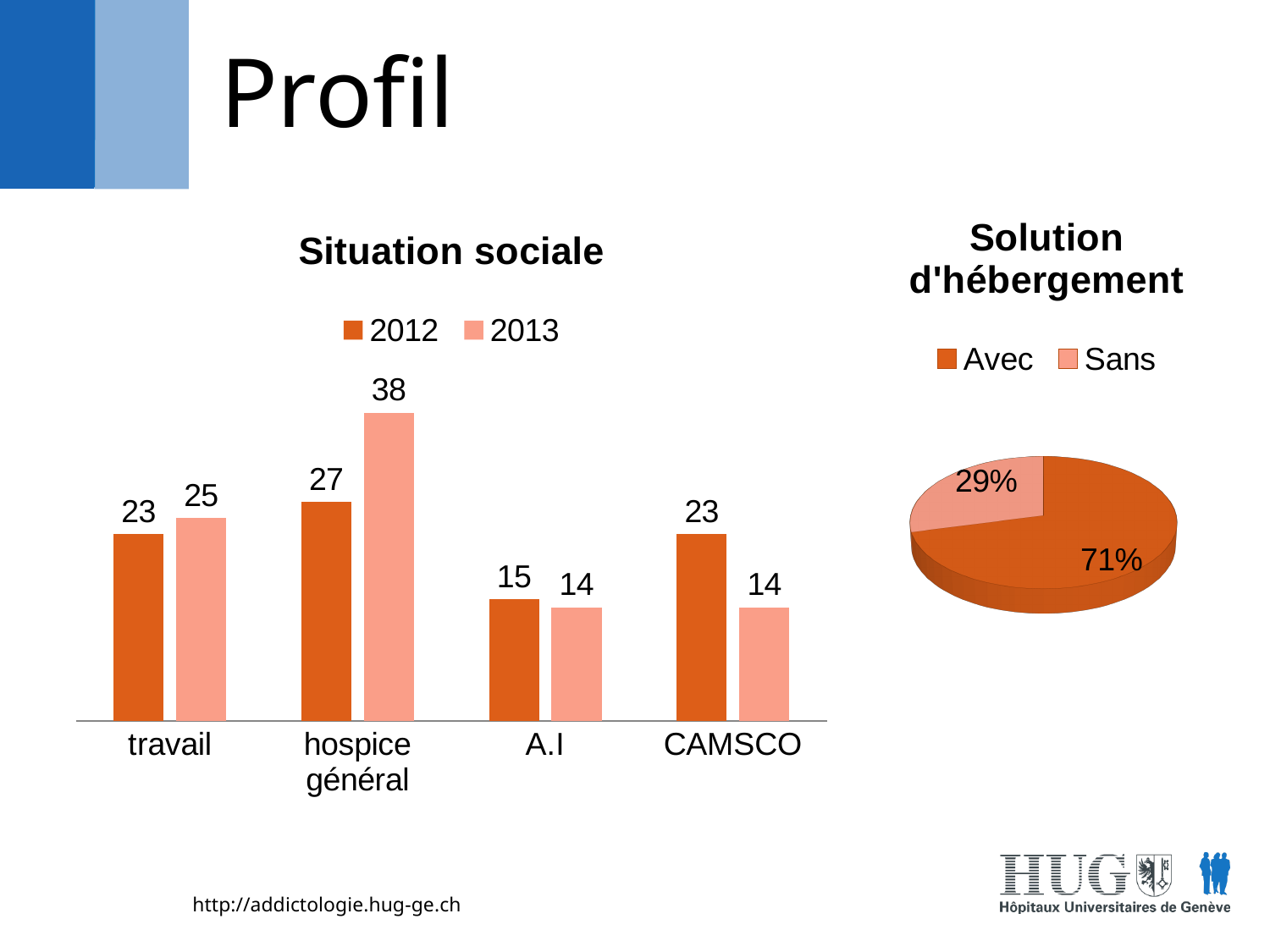
In the 'Situation sociale' chart, which category has the lowest value for 2012? A.I What kind of chart is the 'Solution d'hébergement' chart? pie chart In the 'Solution d'hébergement' chart, what share of the pie is 'Avec'? 71% In the 'Situation sociale' chart, what is the difference between the 2013 and 2012 values for hospice général? 11 In the 'Situation sociale' chart, what is the value for hospice général in 2013? 38 In the 'Situation sociale' chart, what is the value for A.I in 2013? 14 How many series does the legend of the 'Situation sociale' chart list? 2 In the 'Situation sociale' chart, which category has the highest value for 2013? hospice général In the 'Situation sociale' chart, what is the value for CAMSCO in 2012? 23 In the 'Situation sociale' chart, which is larger for CAMSCO: the 2012 value or the 2013 value? 2012 What kind of chart is the 'Situation sociale' chart? bar chart How many categories are shown on the x axis of the 'Situation sociale' chart? 4